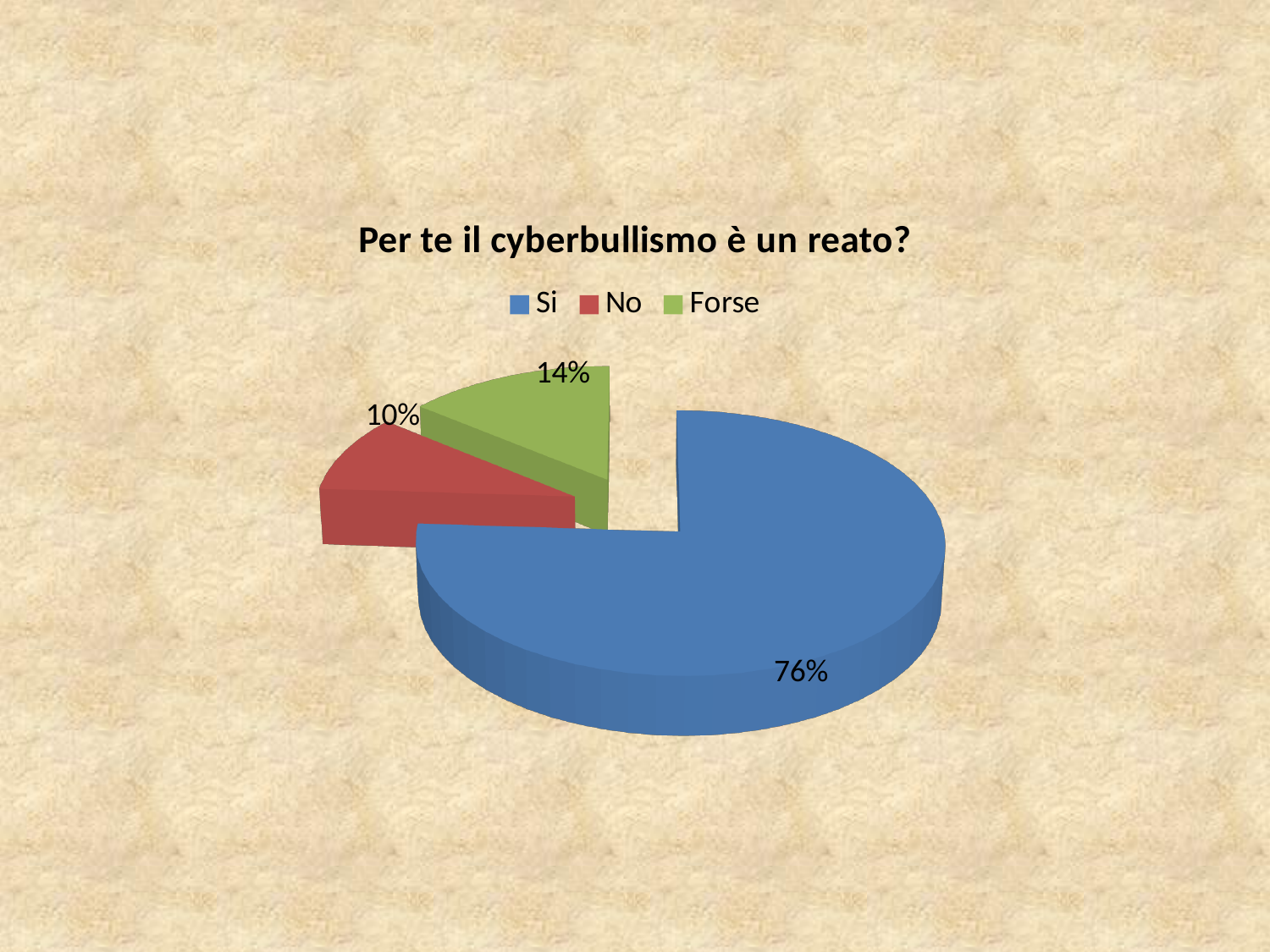
Which slice is larger, "No" or "Forse"? Forse What percentage of the pie is the "Forse" slice? 14% What is the difference in percentage points between the "Si" and "Forse" slices? 62 Which category has the largest share of the pie? Si What percentage of the pie is the "No" slice? 10% What is the difference in percentage points between the "Forse" and "No" slices? 4 What is the title of the chart? Per te il cyberbullismo è un reato? How many slices does the pie chart have? 3 What colour is the "Forse" slice? Green Which category has the smallest share of the pie? No What kind of chart is shown on the slide? Pie chart What percentage of the pie is the "Si" slice? 76%